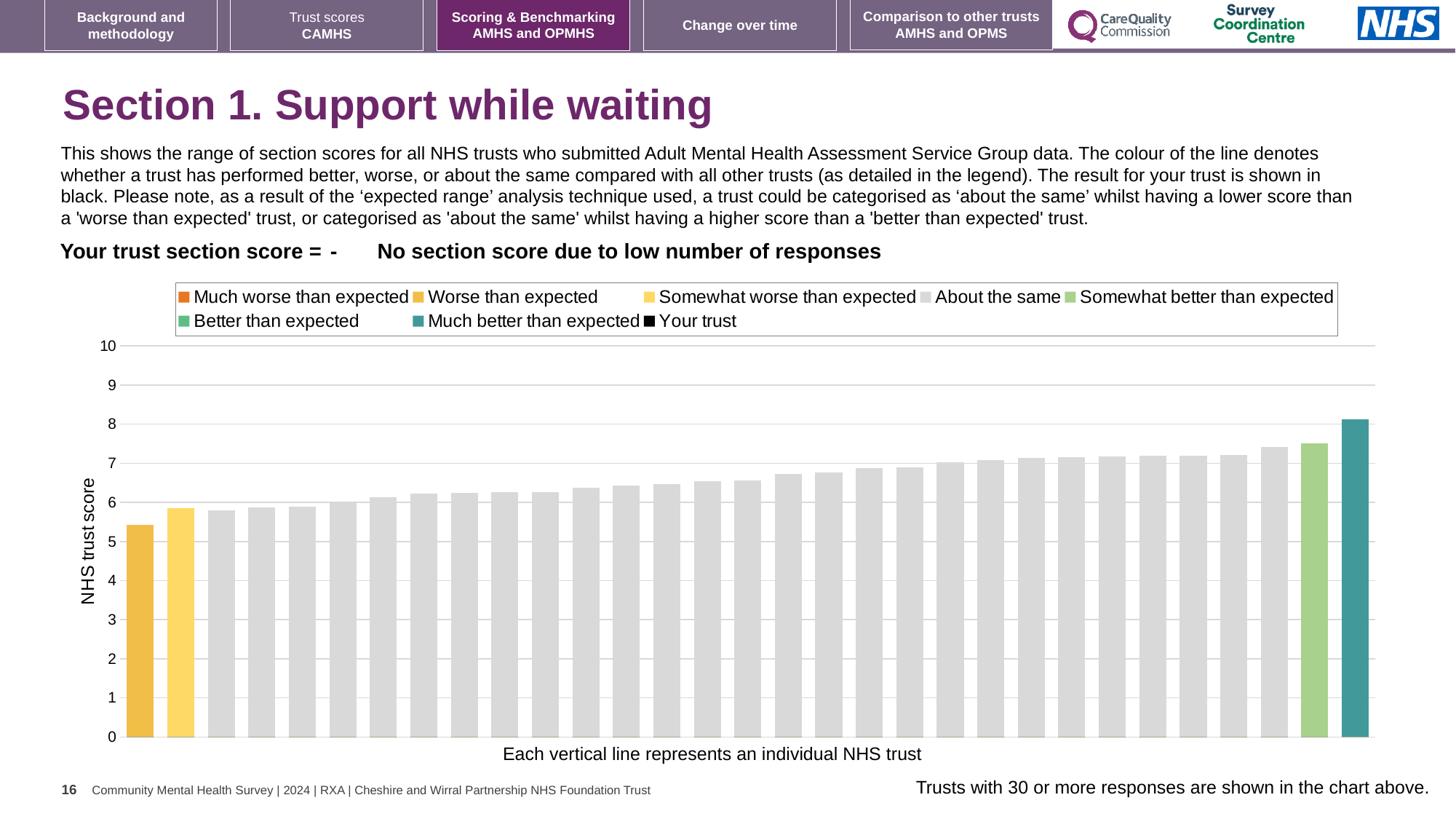
Do the bar values rise or fall from left to right along the x axis? rise How many entries does the chart legend list? 8 Is the value of the leftmost bar greater or less than 5? greater What kind of chart is shown on the slide? bar chart How many bars (NHS trusts) are plotted in the chart? 31 Is the value of the rightmost bar greater or less than 7? greater What is the highest value shown on the vertical axis of the chart? 10 Is the value of the second bar from the left greater or less than 6? less What is the label on the vertical axis of the chart? NHS trust score Which legend category does the shortest bar in the chart belong to? Worse than expected Which legend category does the tallest bar in the chart belong to? Much better than expected